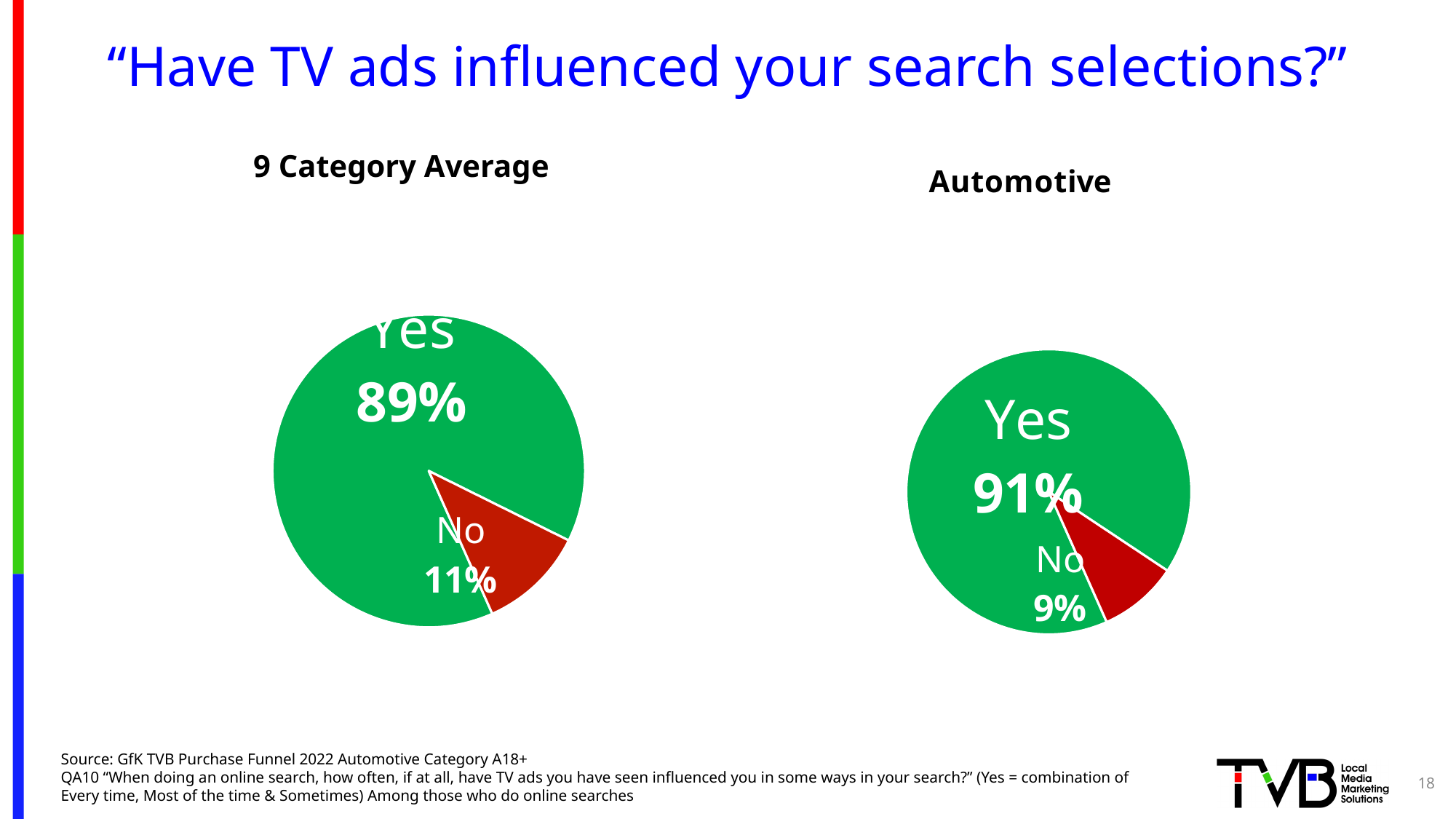
In the 9 Category Average chart, which slice is the smallest? No In the 9 Category Average chart, what percentage answered No? 11% How many slices does the 9 Category Average pie chart have? 2 In the Automotive chart, what percentage answered Yes? 91% What colour is the No slice in the Automotive chart? Red What type of chart is used for the Automotive data? Pie chart Which chart has the larger No share, 9 Category Average or Automotive? 9 Category Average In the Automotive chart, what percentage answered No? 9% In the 9 Category Average chart, what share of the pie does the Yes slice represent? 89% In the Automotive chart, which slice is the largest? Yes What is the difference between the Yes share in the Automotive chart and the Yes share in the 9 Category Average chart? 2 percentage points In the 9 Category Average chart, what percentage answered Yes? 89%